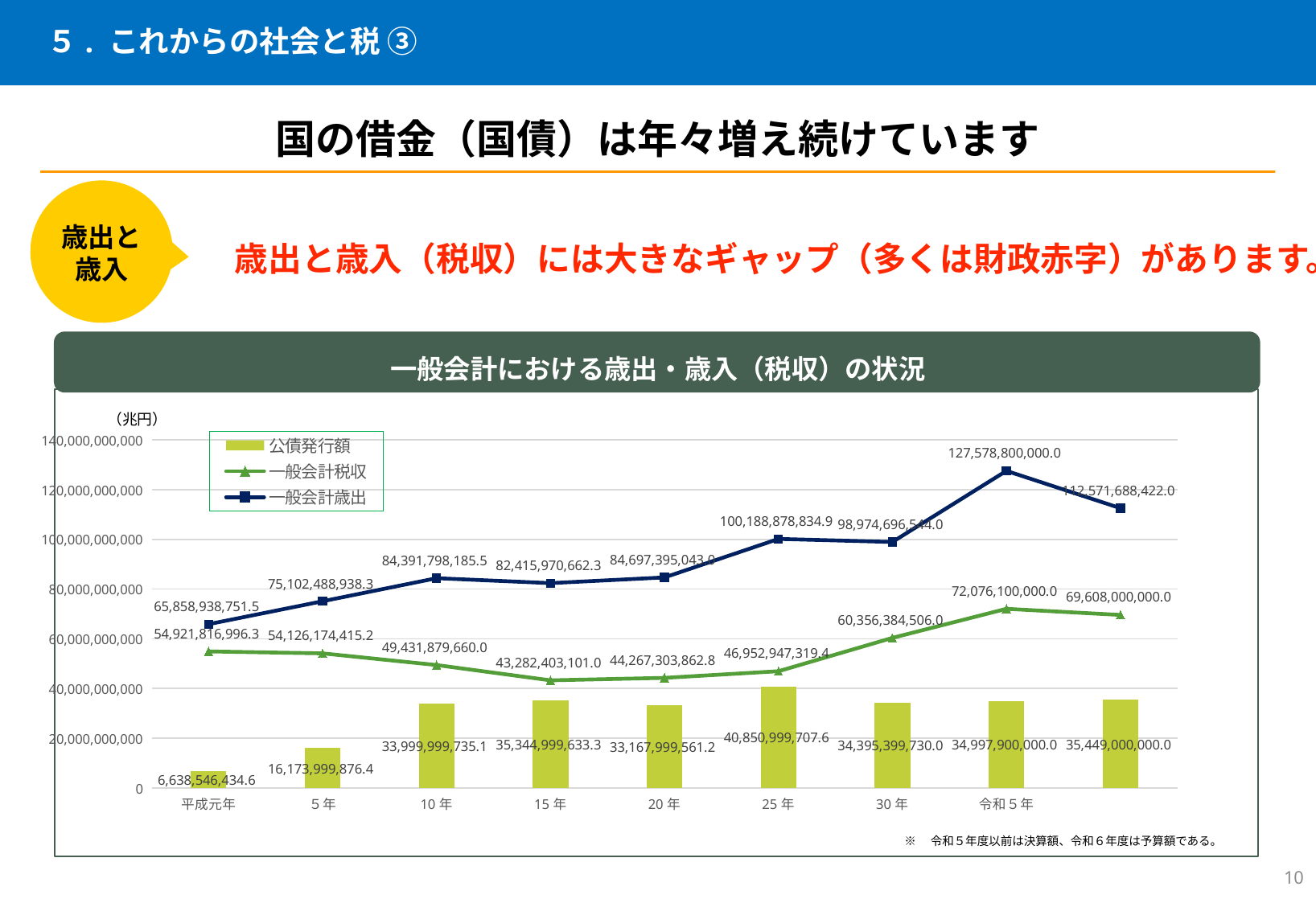
What is the 公債発行額 value for 平成元年? 6,638,546,434.6 In which year is 一般会計税収 the lowest? 15年 What is the 一般会計税収 value for 15年? 43,282,403,101.0 In which year is 公債発行額 the highest? 25年 Which is larger in 30年, 一般会計歳出 or 一般会計税収? 一般会計歳出 What is the 一般会計歳出 value for 令和５年? 127,578,800,000.0 What kind of chart is shown? Combined bar and line chart How many bars are plotted for 公債発行額? 9 Does 一般会計歳出 generally rise or fall from 平成元年 to 令和５年? rise What is the difference between 一般会計歳出 and 一般会計税収 in 令和５年? 55,502,700,000.0 How many series does the legend list? 3 Is the 一般会計歳出 value for 10年 greater or less than 80,000,000,000? greater